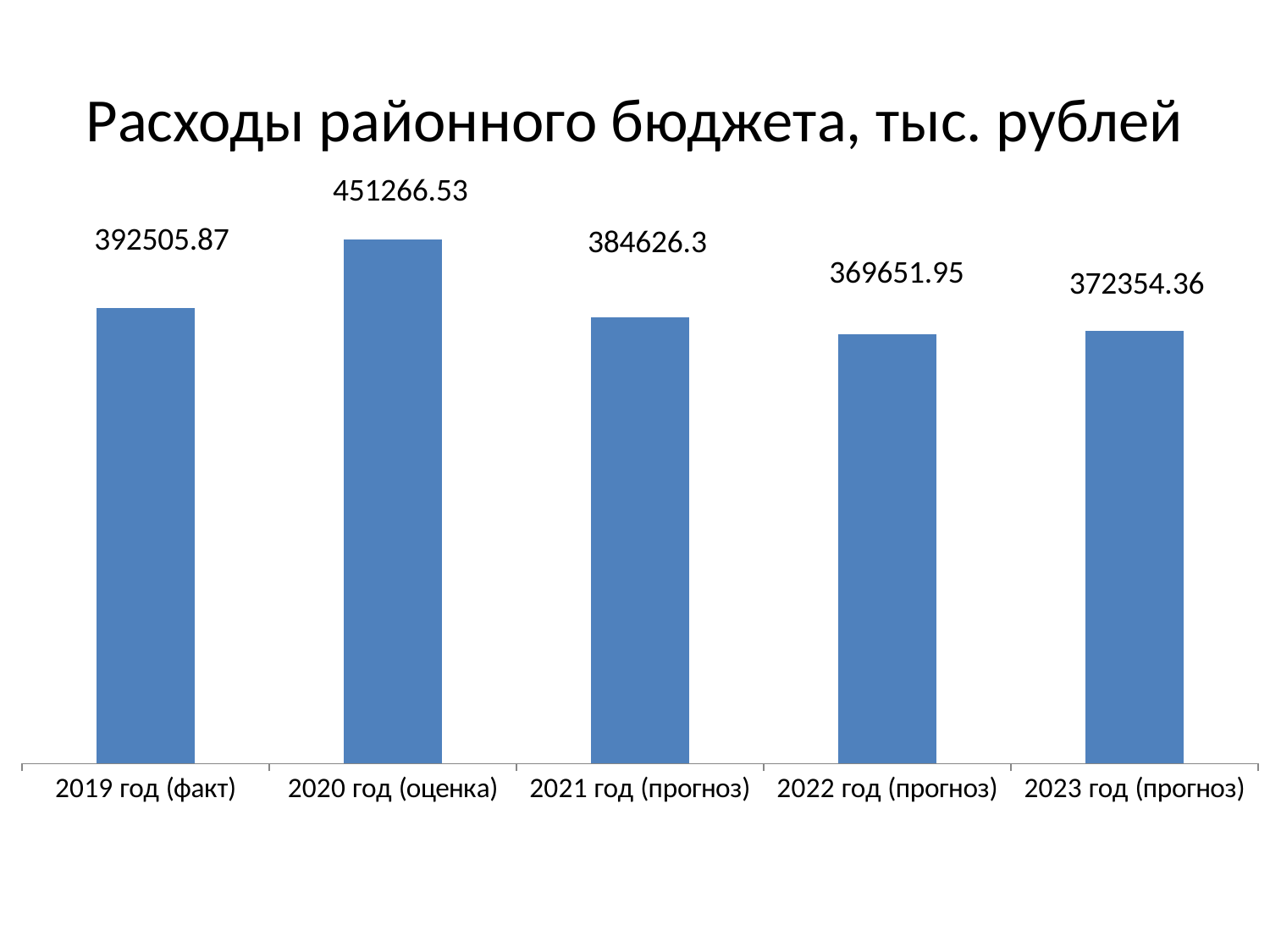
What is the difference between the values for 2020 год (оценка) and 2019 год (факт)? 58760.66 What is the value for 2019 год (факт)? 392505.87 What is the value for 2023 год (прогноз)? 372354.36 What is the difference between the values for 2019 год (факт) and 2021 год (прогноз)? 7879.57 What kind of chart is shown on the slide? bar chart Which category has the highest value? 2020 год (оценка) How many categories are shown in the chart? 5 What is the value for 2020 год (оценка)? 451266.53 Which category has the lowest value? 2022 год (прогноз) Which is larger, the value for 2019 год (факт) or the value for 2021 год (прогноз)? 2019 год (факт) What is the title of the chart? Расходы районного бюджета, тыс. рублей What is the value for 2021 год (прогноз)? 384626.3